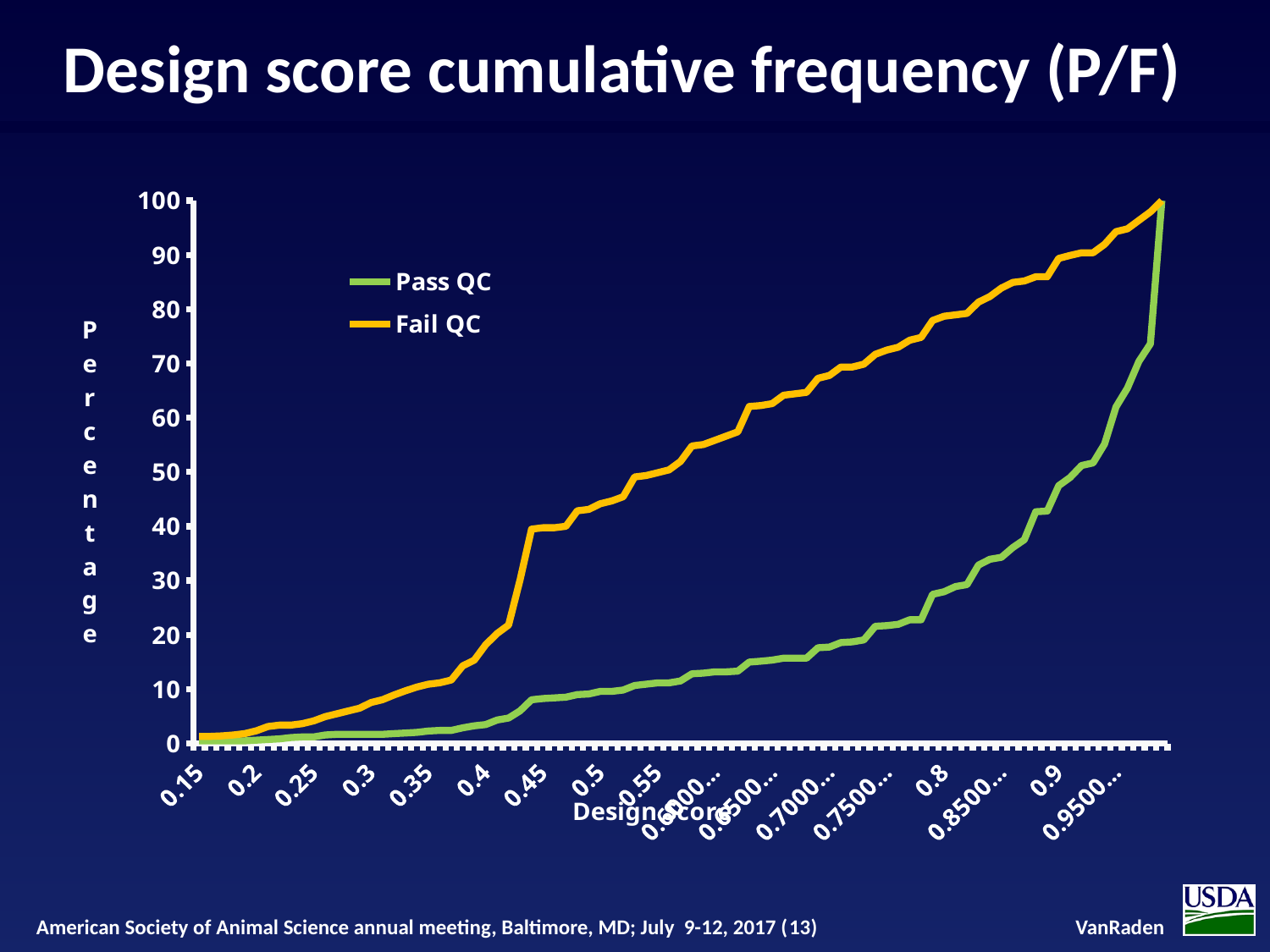
Do the Pass QC values rise or fall as the design score increases along the x axis? rise What are the two series named in the legend? Pass QC and Fail QC What kind of chart is shown on the slide? line chart Is the Fail QC value at a design score of 0.8 greater or less than 70? greater Do the Fail QC values rise or fall as the design score increases along the x axis? rise Is the Fail QC value at a design score of 0.5 greater or less than 30? greater At a design score of 0.6, which series has the higher percentage, Pass QC or Fail QC? Fail QC Is the Pass QC value at a design score of 0.4 greater or less than 10? less What is the title of the chart? Design score cumulative frequency (P/F) How many series does the legend list? 2